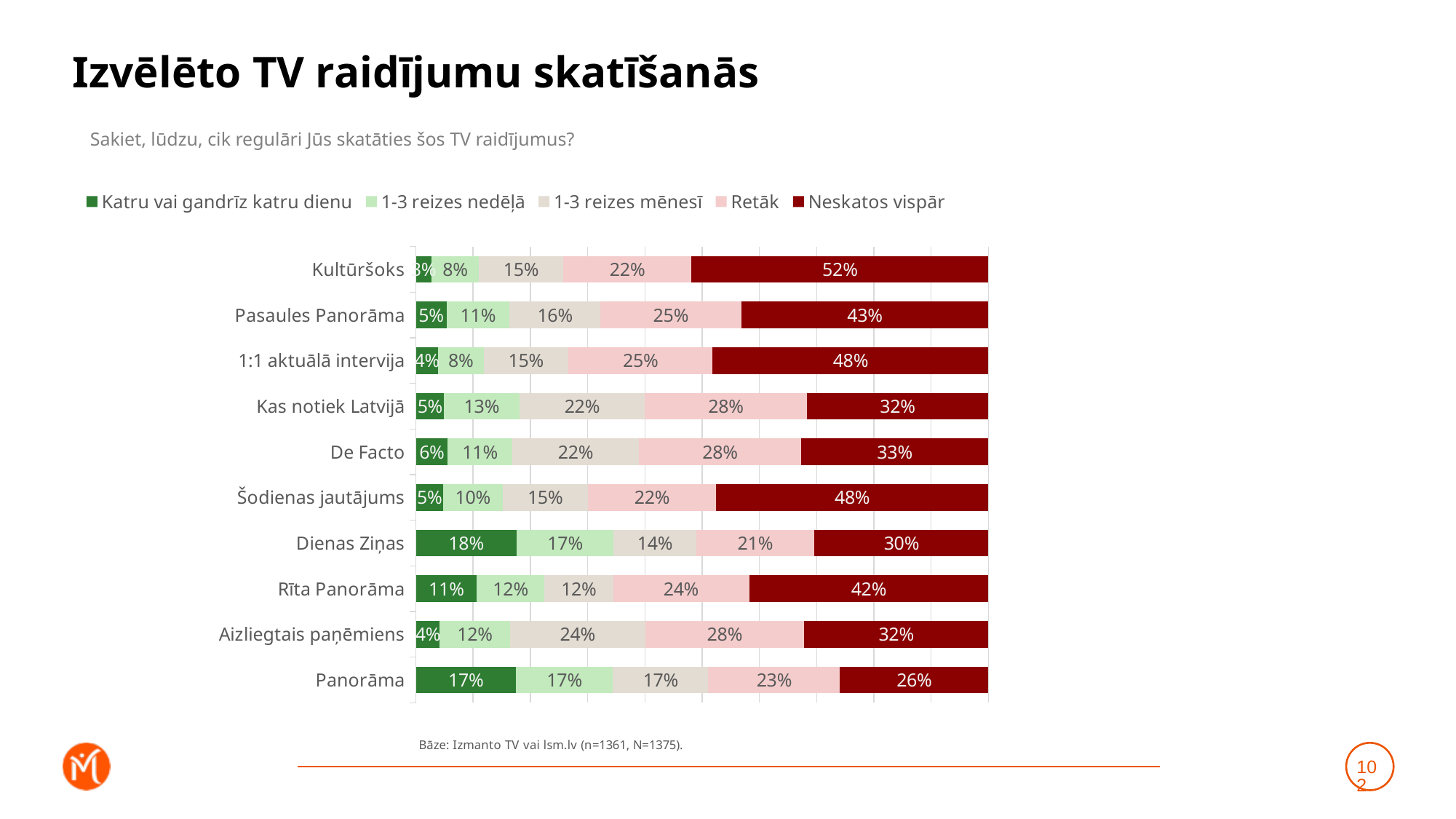
Which programme has the highest "Katru vai gandrīz katru dienu" value? Dienas Ziņas What is the "Retāk" value for Aizliegtais paņēmiens? 28% How many series does the legend list? 5 What is the "Katru vai gandrīz katru dienu" value for Dienas Ziņas? 18% Which is larger: the "Katru vai gandrīz katru dienu" value for Dienas Ziņas or for Rīta Panorāma? Dienas Ziņas Which programme has the lowest "Neskatos vispār" value? Panorāma Which programme has the highest "Neskatos vispār" value? Kultūršoks How many TV programmes (categories) are listed on the chart? 10 What type of chart is shown on the slide? Stacked bar chart What is the total of the stacked bar for Panorāma? 100% What is the difference between the "Neskatos vispār" values for Kultūršoks and Panorāma? 26 percentage points What is the "Neskatos vispār" value for Kultūršoks? 52%